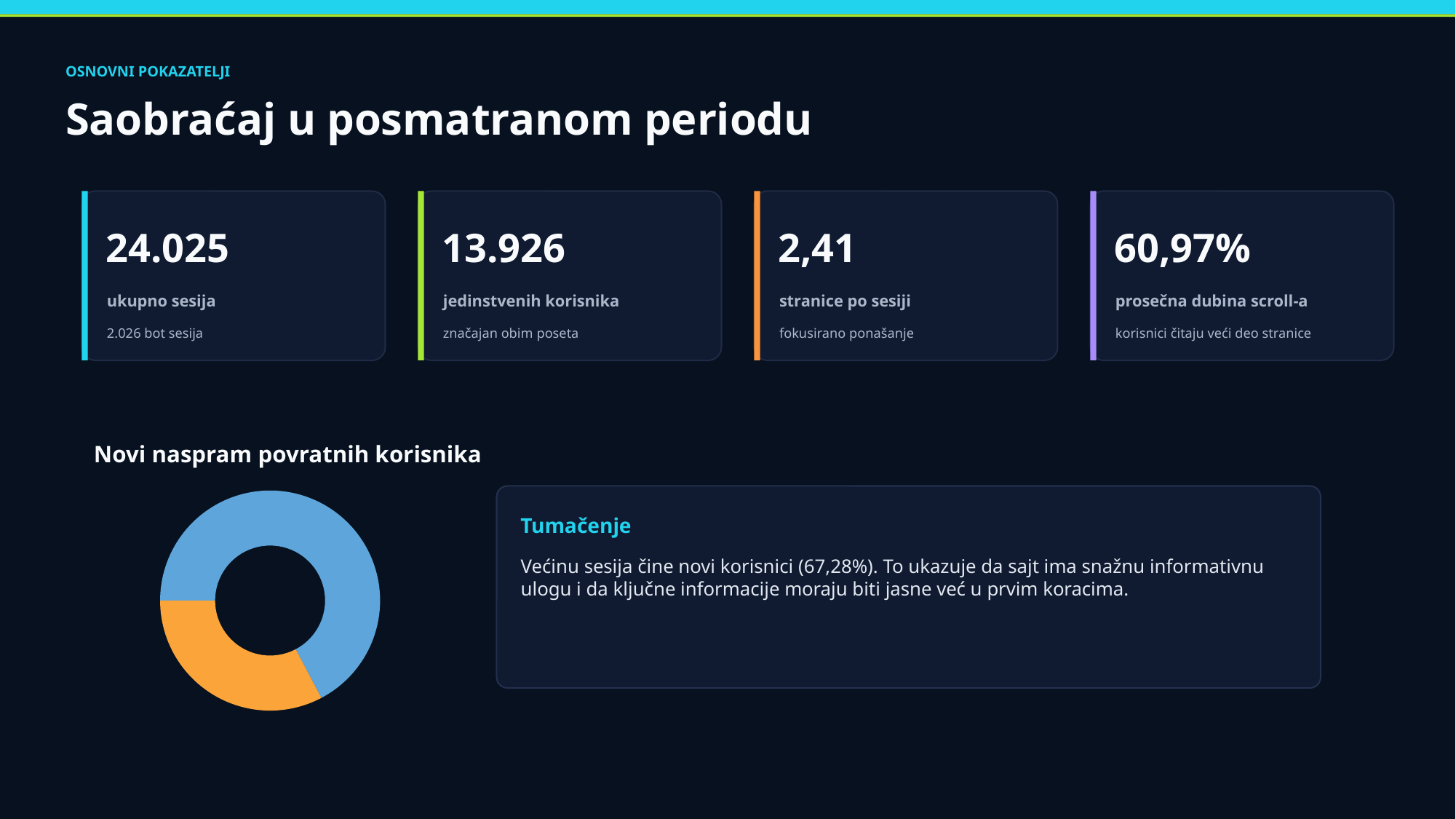
In the "Novi naspram povratnih korisnika" chart, which slice is larger, the blue one or the orange one? blue What kind of chart is shown under the heading "Novi naspram povratnih korisnika"? pie chart (donut) What is the title of the donut chart on the slide? Novi naspram povratnih korisnika How many slices does the "Novi naspram povratnih korisnika" chart have? 2 In the "Novi naspram povratnih korisnika" chart, is the orange slice greater or less than half of the chart? less In the "Novi naspram povratnih korisnika" chart, is the blue slice greater or less than half of the chart? greater What two colours are used for the slices of the "Novi naspram povratnih korisnika" chart? blue and orange According to the slide, what share of sessions do new users (novi korisnici) make up in the "Novi naspram povratnih korisnika" chart? 67,28%